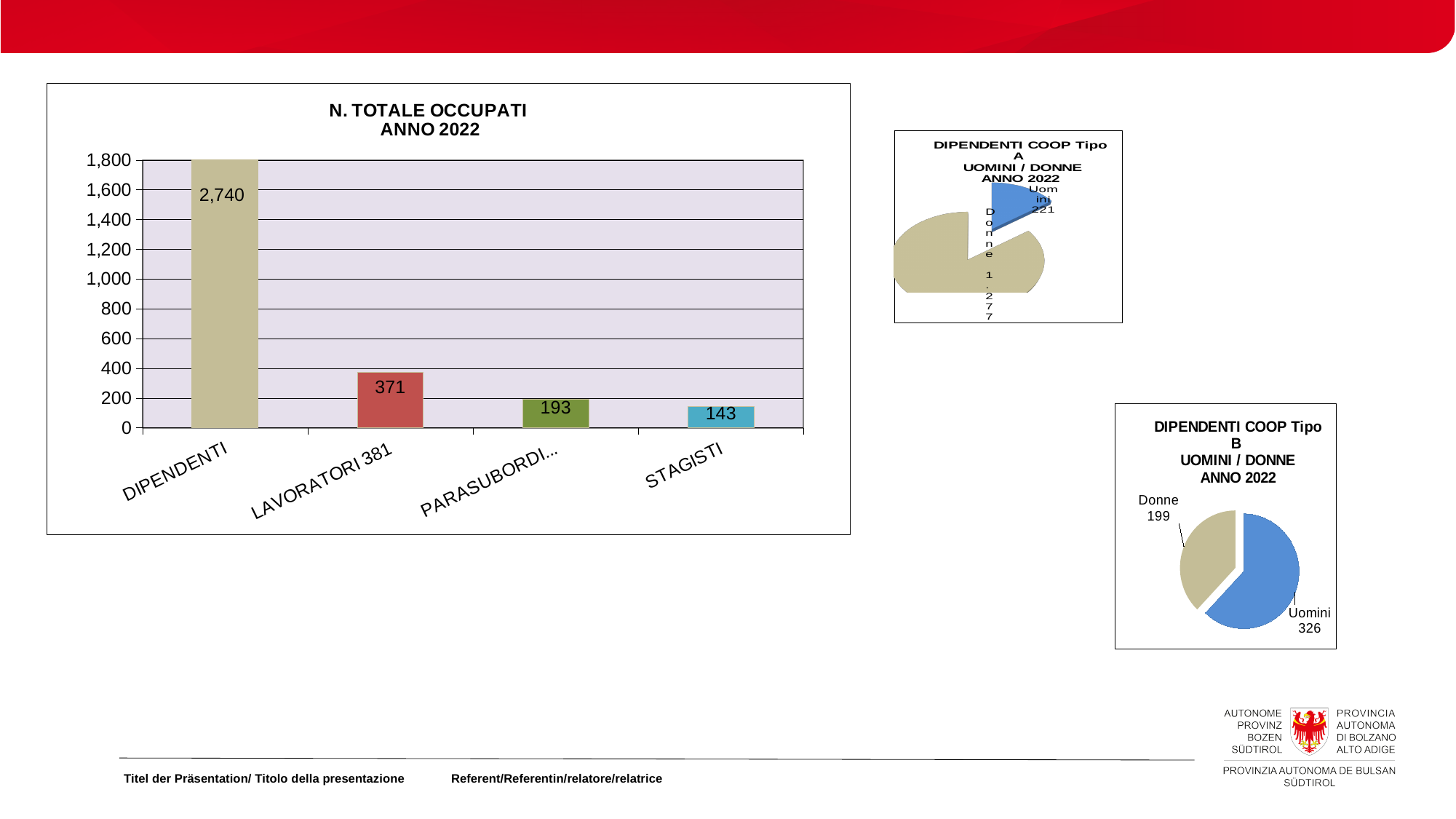
In the pie chart 'DIPENDENTI COOP Tipo A UOMINI / DONNE ANNO 2022', what is the value for Uomini? 221 In the bar chart 'N. TOTALE OCCUPATI ANNO 2022', which category has the highest value? DIPENDENTI In the pie chart 'DIPENDENTI COOP Tipo B UOMINI / DONNE ANNO 2022', which slice is larger, Donne or Uomini? Uomini In the bar chart 'N. TOTALE OCCUPATI ANNO 2022', how many categories are shown on the x axis? 4 In the bar chart 'N. TOTALE OCCUPATI ANNO 2022', what is the value for STAGISTI? 143 In the bar chart 'N. TOTALE OCCUPATI ANNO 2022', which category has the lowest value? STAGISTI In the bar chart 'N. TOTALE OCCUPATI ANNO 2022', what is the value for DIPENDENTI? 2,740 What kind of chart is 'N. TOTALE OCCUPATI ANNO 2022'? bar chart In the bar chart 'N. TOTALE OCCUPATI ANNO 2022', what is the value for the category labelled 'LAVORATORI 381'? 371 In the bar chart 'N. TOTALE OCCUPATI ANNO 2022', what is the difference between the values for 'LAVORATORI 381' and STAGISTI? 228 In the pie chart 'DIPENDENTI COOP Tipo B UOMINI / DONNE ANNO 2022', what is the value for Uomini? 326 In the bar chart 'N. TOTALE OCCUPATI ANNO 2022', do the values rise or fall from left to right along the x axis? fall